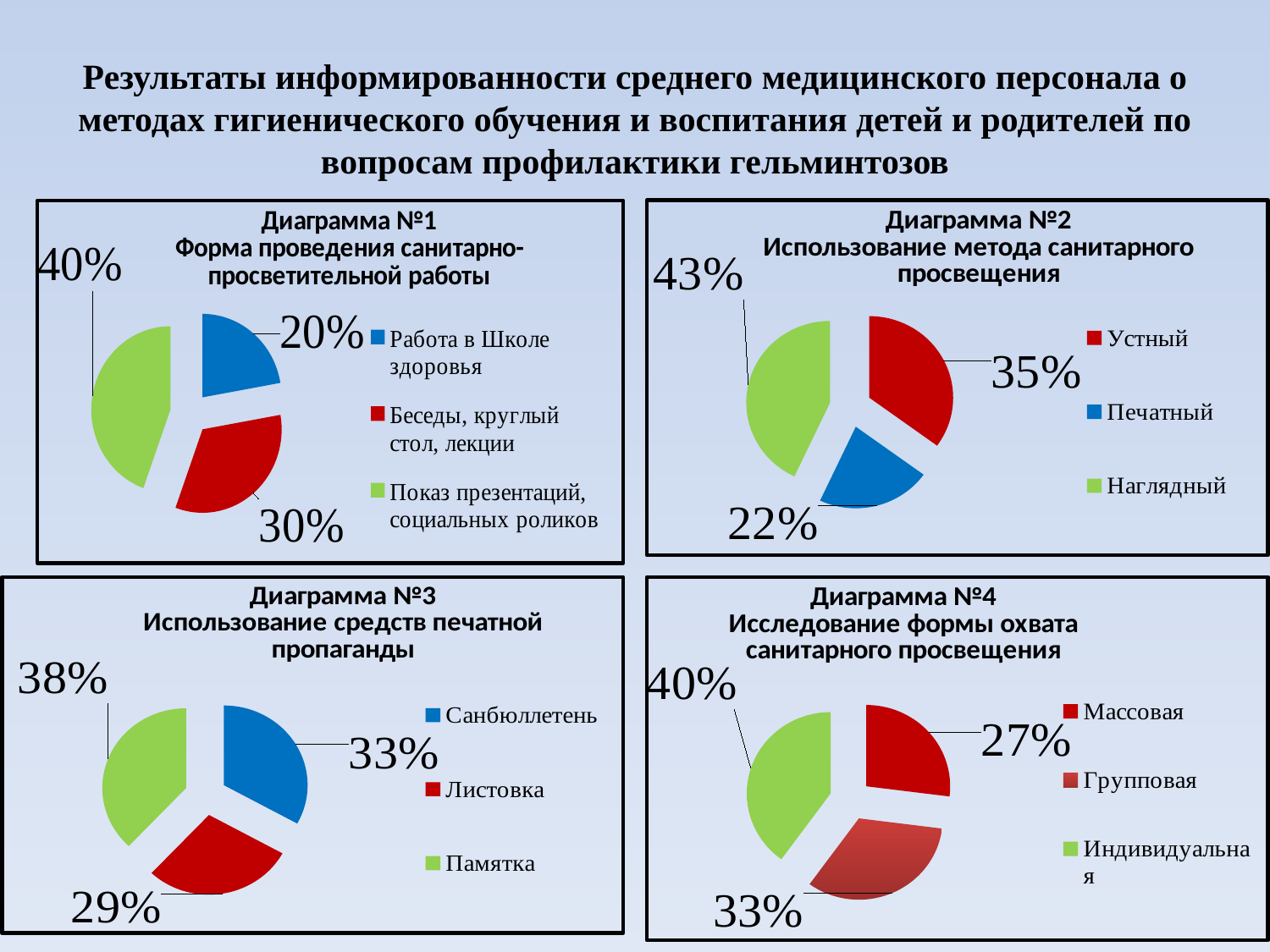
In Диаграмма №2, which category has the largest share? Наглядный In Диаграмма №1, what is the difference between the shares for «Беседы, круглый стол, лекции» and «Работа в Школе здоровья»? 10% In Диаграмма №2, which is larger: «Устный» or «Печатный»? Устный In Диаграмма №4, what is the difference between the shares for «Индивидуальная» and «Массовая»? 13% What type of chart is Диаграмма №3? Pie chart In Диаграмма №1, what share is shown for «Показ презентаций, социальных роликов»? 40% In Диаграмма №1, which category has the smallest share? Работа в Школе здоровья In Диаграмма №4, what share is shown for «Групповая»? 33% In Диаграмма №2, what share is shown for «Печатный»? 22% How many series does the legend of Диаграмма №4 list? 3 In Диаграмма №3, what share is shown for «Листовка»? 29% In Диаграмма №3, which category has the largest share? Памятка